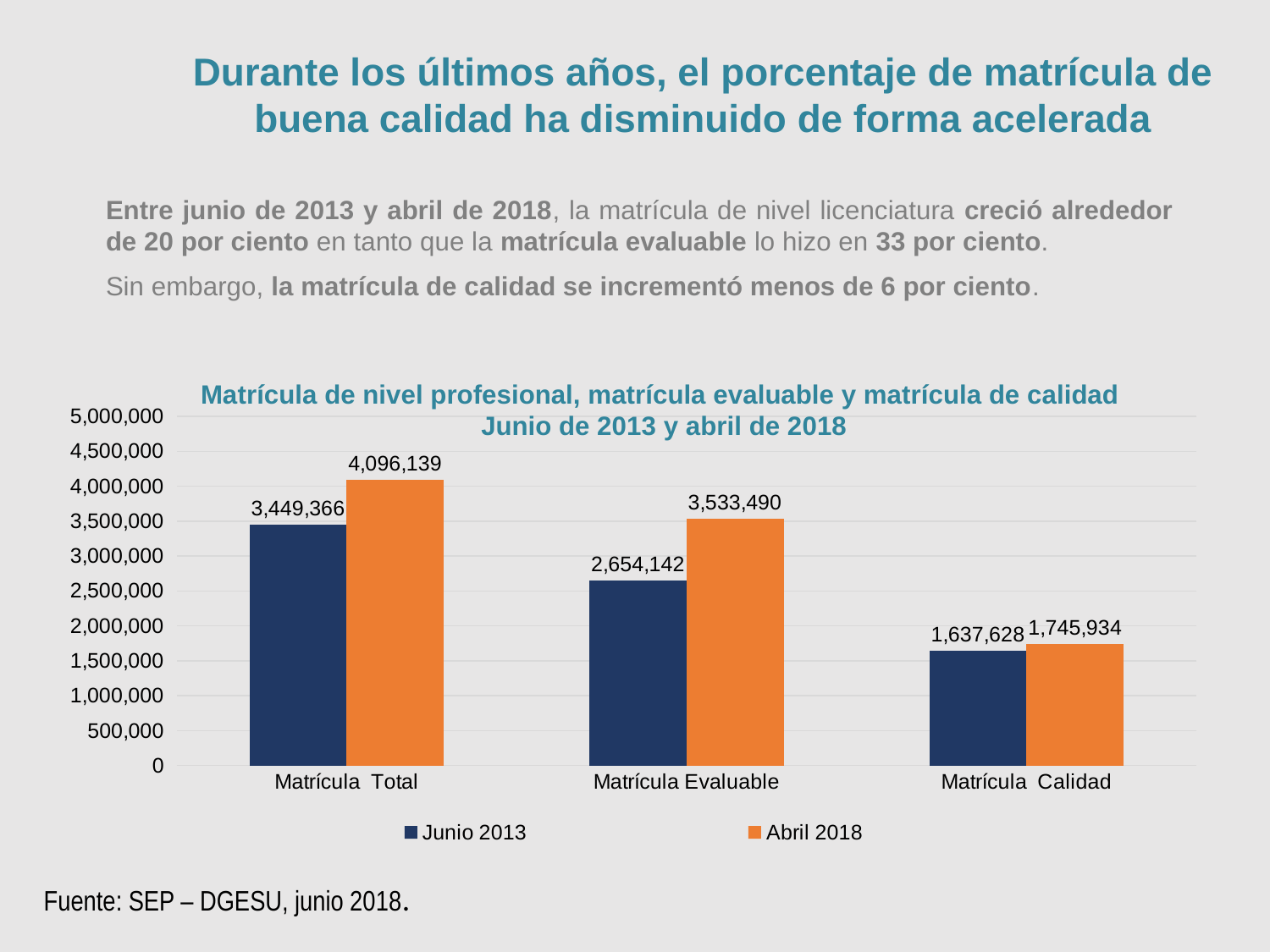
Which category has the highest value for Junio 2013? Matrícula Total What is the value for Matrícula Total in Junio 2013? 3,449,366 How many series does the chart legend list? 2 Which category has the lowest value for Abril 2018? Matrícula Calidad Which is larger: Matrícula Evaluable in Abril 2018 or Matrícula Total in Junio 2013? Matrícula Evaluable in Abril 2018 What type of chart is shown on the slide? Bar chart What is the difference between the Abril 2018 and Junio 2013 values for Matrícula Evaluable? 879,348 What is the difference between the Abril 2018 and Junio 2013 values for Matrícula Calidad? 108,306 What is the value for Matrícula Total in Abril 2018? 4,096,139 What is the value for Matrícula Evaluable in Abril 2018? 3,533,490 What is the value for Matrícula Calidad in Junio 2013? 1,637,628 How many categories are shown on the x axis of the chart? 3